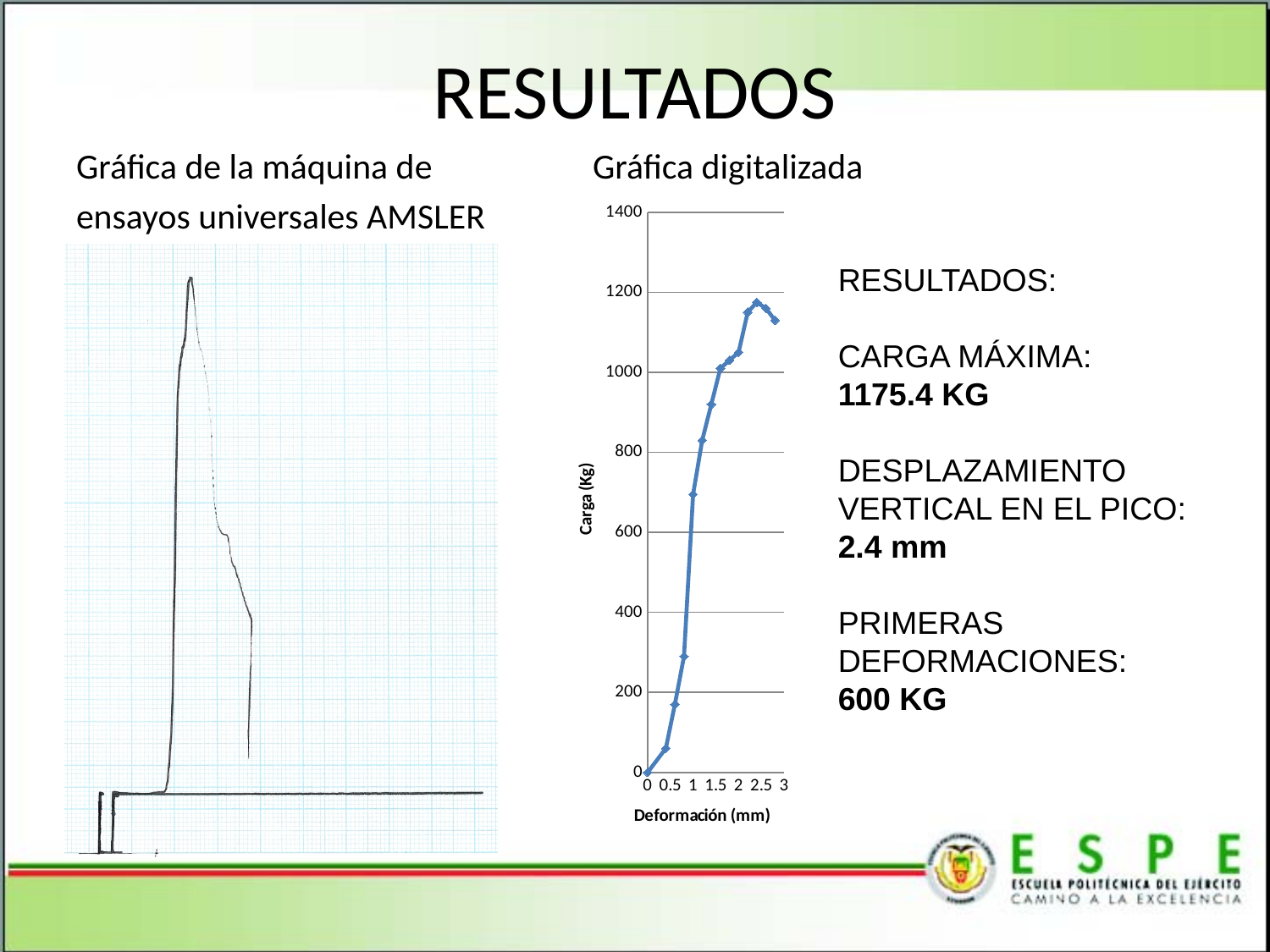
According to the slide, what is the maximum load (carga máxima) reached in the digitized chart? 1175.4 KG In the 'Gráfica digitalizada' chart, what is the label of the horizontal axis? Deformación (mm) In the 'Gráfica digitalizada' chart, is the load at a deformation of 0.5 mm greater or less than 200? less In the 'Gráfica digitalizada' chart, does the load rise or fall as deformation increases from 0 mm to 2 mm? rise In the 'Gráfica digitalizada' chart, what is the label of the vertical axis? Carga (Kg) What kind of chart is the 'Gráfica digitalizada'? line chart According to the slide, at what vertical displacement does the peak load occur? 2.4 mm How many data series are plotted in the 'Gráfica digitalizada' chart? 1 In the 'Gráfica digitalizada' chart, is the load at a deformation of 2 mm greater or less than 800? greater In the 'Gráfica digitalizada' chart, what is the highest value shown on the vertical axis? 1400 In the 'Gráfica digitalizada' chart, what is the highest value shown on the horizontal axis? 3 In the 'Gráfica digitalizada' chart, does the load rise or fall after the peak near 2.4 mm? fall